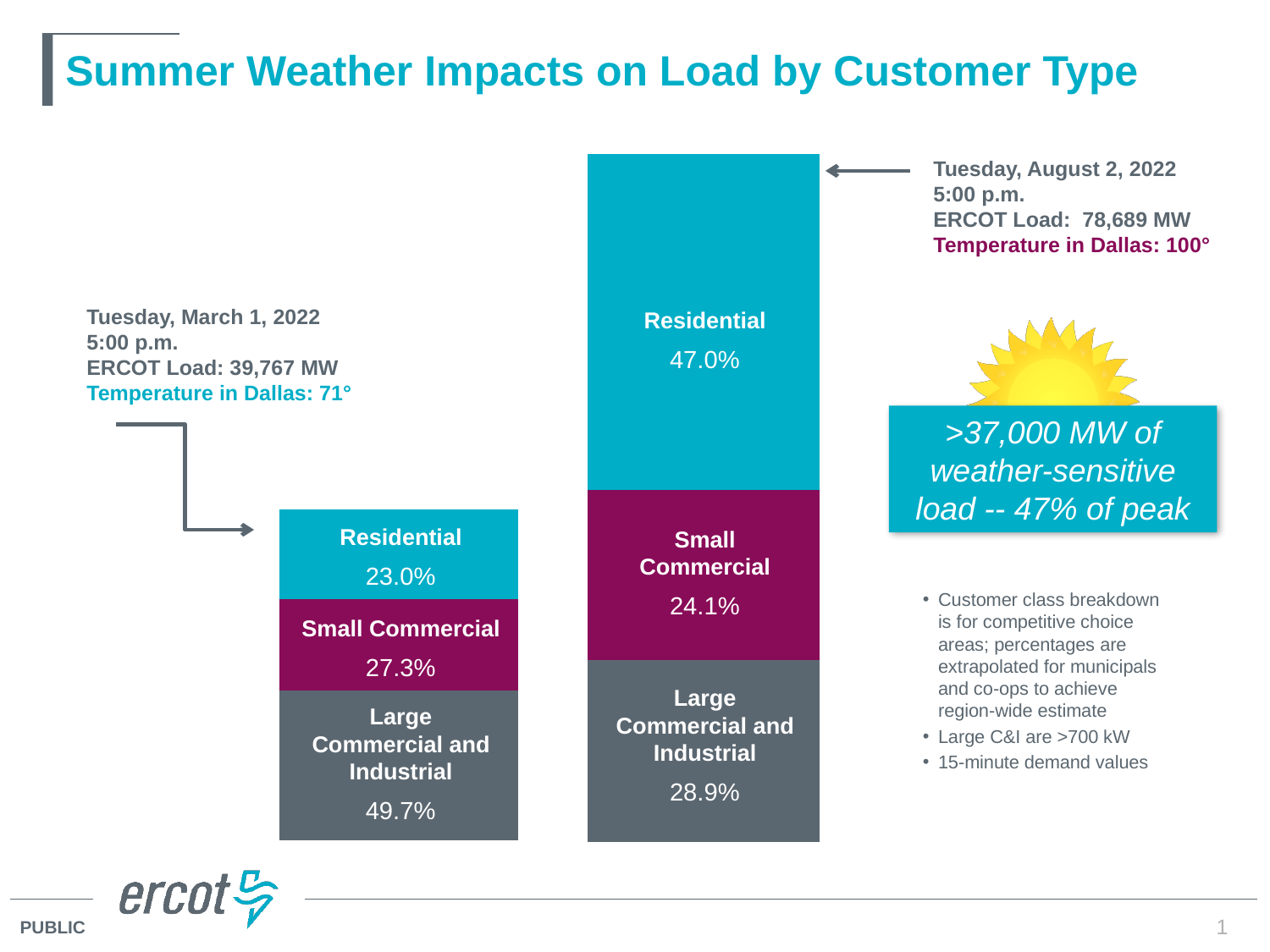
What is the title of the slide? Summer Weather Impacts on Load by Customer Type Which is larger: the Small Commercial share on March 1, 2022 or on August 2, 2022? March 1, 2022 What is the difference between the Residential share on August 2, 2022 and on March 1, 2022? 24.0% How many customer types are shown in each stacked bar? 3 What share of load is Large Commercial and Industrial in the March 1, 2022 bar? 49.7% What share of load is Small Commercial in the August 2, 2022 bar? 24.1% What share of load is Residential in the August 2, 2022 bar? 47.0% What share of load is Residential in the March 1, 2022 bar? 23.0% What is the ERCOT Load stated for Tuesday, August 2, 2022? 78,689 MW What kind of chart is shown on the slide? Stacked bar chart Which customer type has the smallest share in the August 2, 2022 bar? Small Commercial Which customer type has the largest share in the March 1, 2022 bar? Large Commercial and Industrial